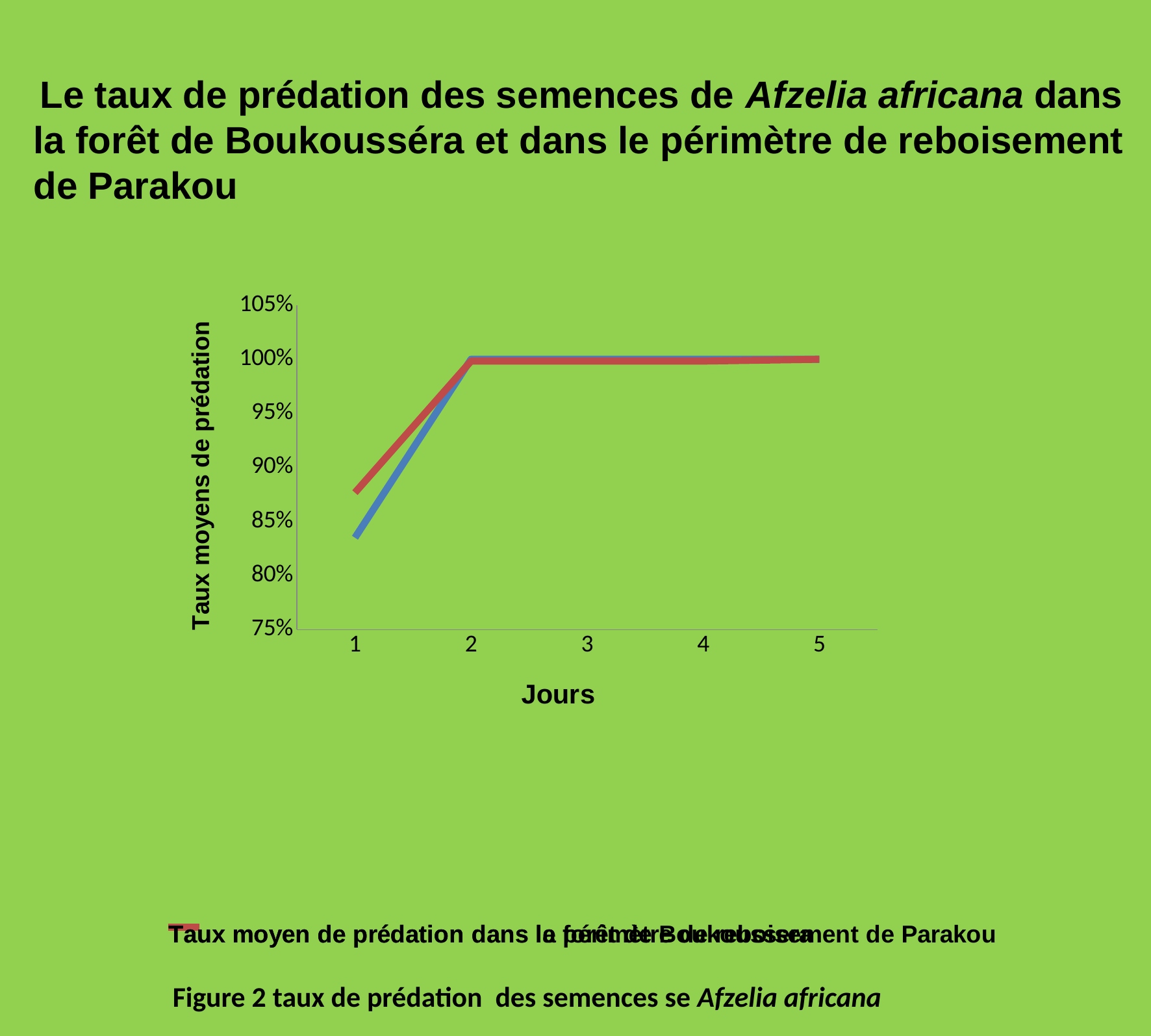
How many lines are plotted on the chart? 2 What is the value of the blue line at day 5? 100% On which day does the blue line have its lowest value? 1 How many days (points) are shown along the x axis of the chart? 5 Is the value of the red line at day 1 greater or less than 85%? greater Is the value of the red line at day 1 greater or less than 90%? less Is the value of the blue line at day 1 greater or less than 85%? less At day 1, which line has the higher value, the red line or the blue line? the red line What kind of chart is shown on the slide? line chart What is the title of the y axis of the chart? Taux moyens de prédation What is the title of the x axis of the chart? Jours